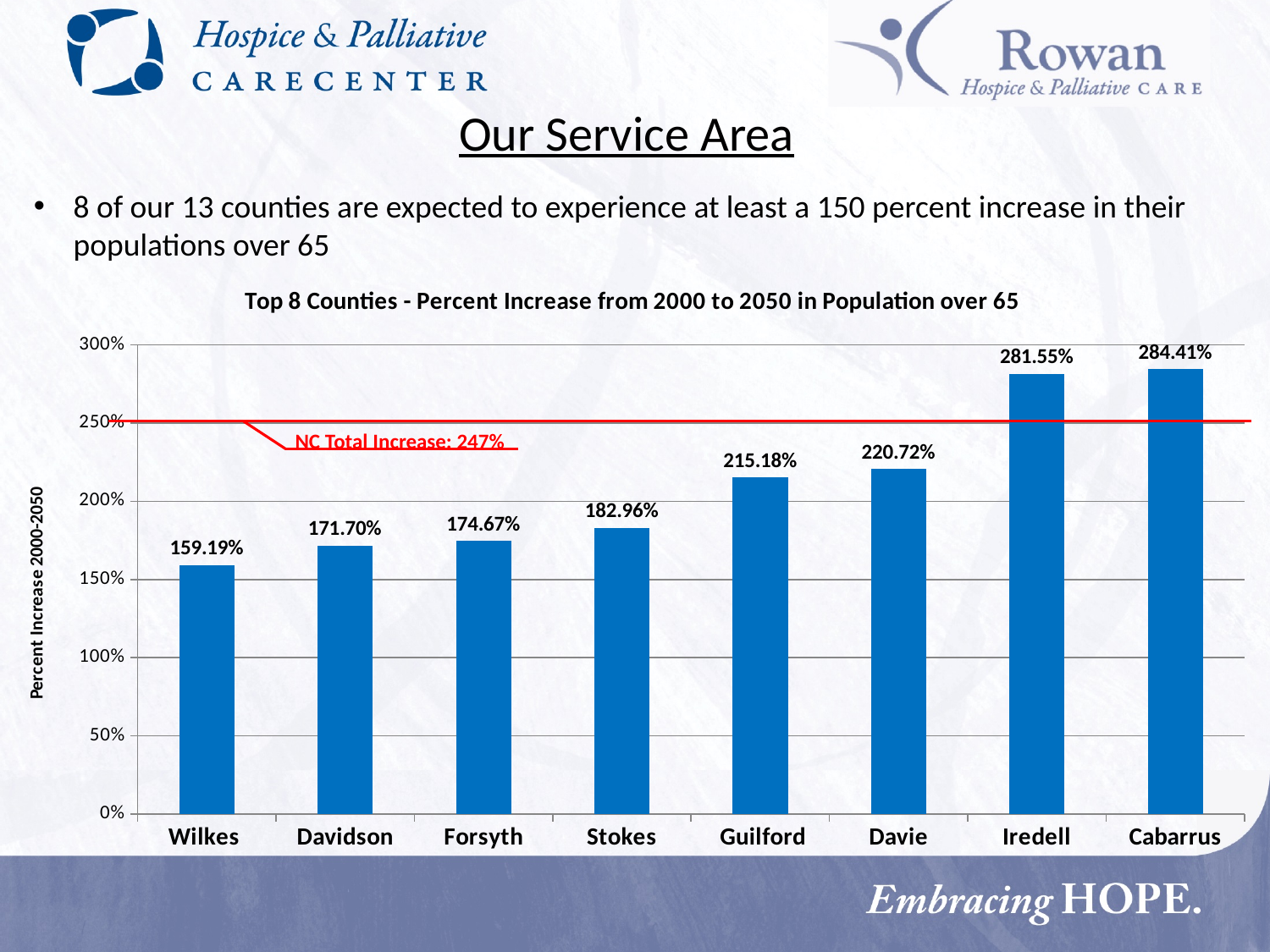
Do the values rise or fall from Wilkes to Cabarrus along the x axis? rise What is the difference between the percent increase for Davie and for Stokes? 37.76% What is the percent increase shown for Guilford? 215.18% Which county has the lowest percent increase? Wilkes Is the value for Guilford greater or less than 200%? greater What is the percent increase shown for Iredell? 281.55% What kind of chart is shown on the slide? bar chart Which has a larger percent increase, Forsyth or Davidson? Forsyth What value does the red horizontal line labelled 'NC Total Increase' represent? 247% How many counties are shown in the chart? 8 Which county has the highest percent increase? Cabarrus What is the percent increase shown for Wilkes? 159.19%